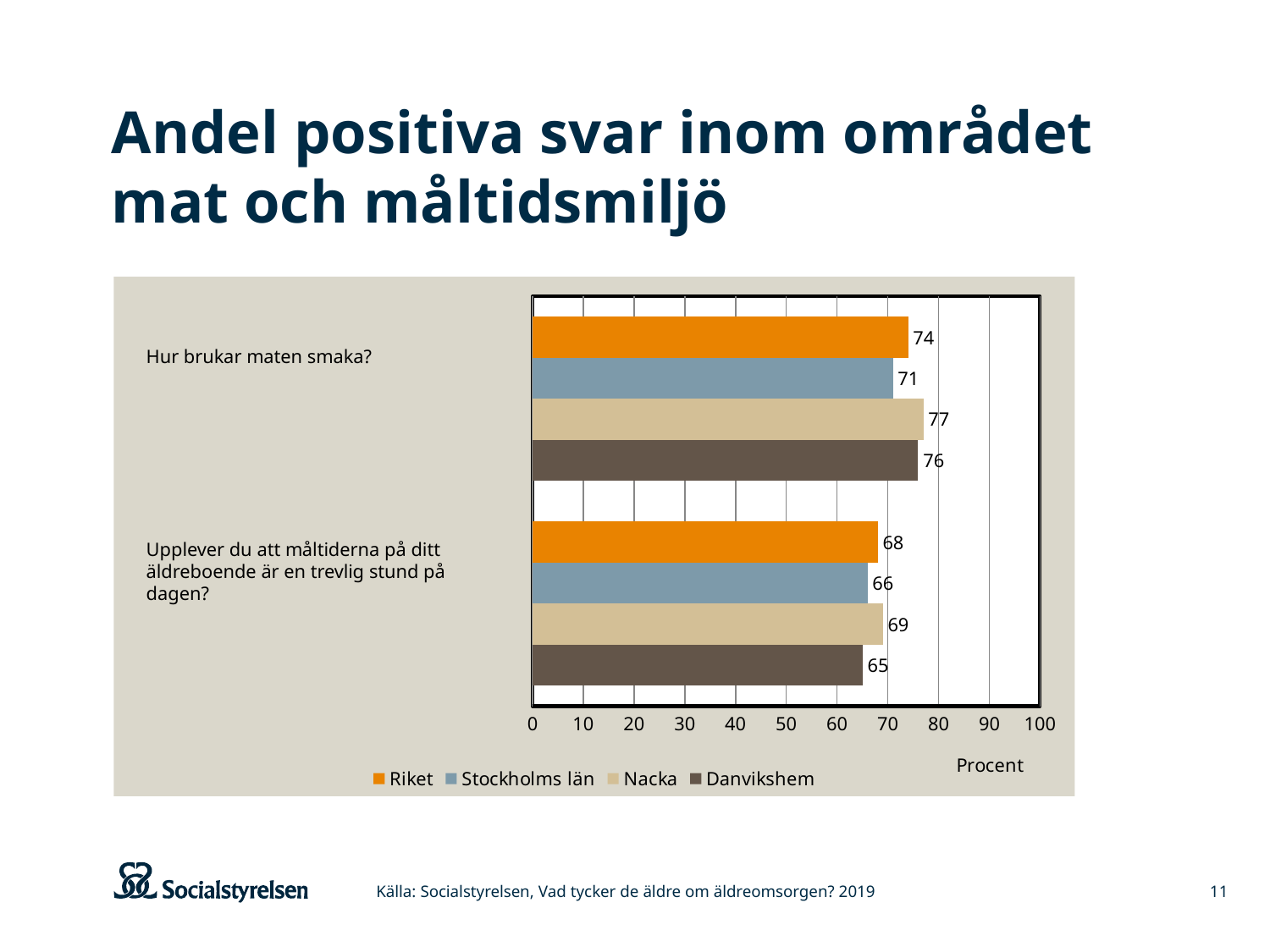
Which series has the highest value for "Hur brukar maten smaka?"? Nacka What kind of chart is shown on the slide? Bar chart What is the value for Riket on the question "Hur brukar maten smaka?"? 74 What is the value for Danvikshem on the question "Upplever du att måltiderna på ditt äldreboende är en trevlig stund på dagen?"? 65 What is the difference between the Nacka and Stockholms län values for "Hur brukar maten smaka?"? 6 What unit is shown on the horizontal axis of the chart? Procent Which series has the lowest value for "Upplever du att måltiderna på ditt äldreboende är en trevlig stund på dagen?"? Danvikshem What is the value for Nacka on the question "Hur brukar maten smaka?"? 77 How many series does the legend list? 4 Which is larger for Danvikshem: the value for "Hur brukar maten smaka?" or for "Upplever du att måltiderna på ditt äldreboende är en trevlig stund på dagen?"? Hur brukar maten smaka? How many questions (categories) are shown on the chart? 2 What is the value for Stockholms län on the question "Upplever du att måltiderna på ditt äldreboende är en trevlig stund på dagen?"? 66